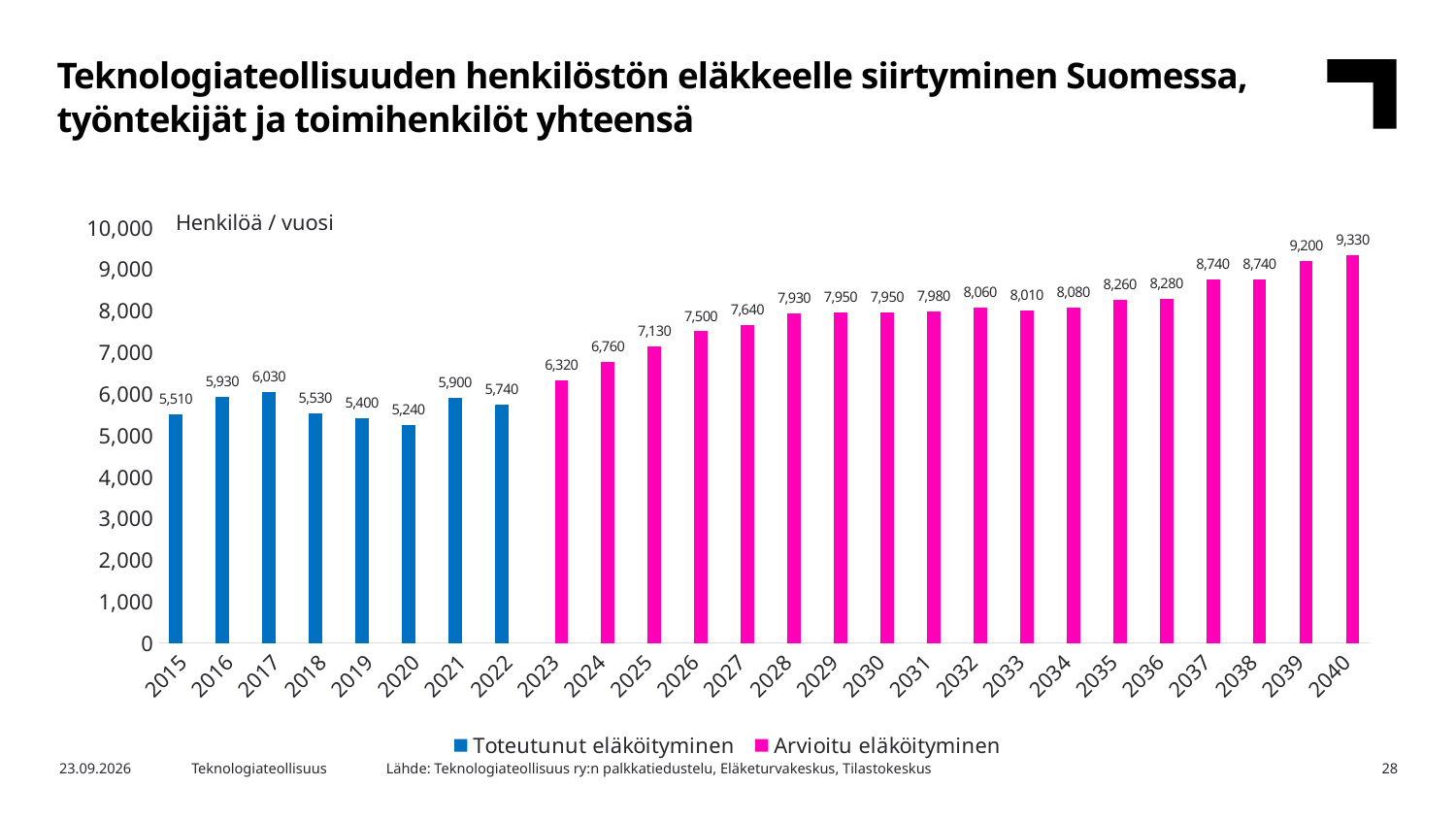
What is the value for 2040? 9,330 What is the value for 2023? 6,320 Which year has the highest value? 2040 What is the difference between the values for 2040 and 2015? 3,820 How many series does the legend list? 2 Which year has the lowest value? 2020 What is the value for 2020? 5,240 Is the value for 2035 greater or less than 8,000? greater How many years are shown on the x axis? 26 Do the values generally rise or fall from 2023 to 2040? rise What kind of chart is shown on the slide? bar chart Which is larger, the value for 2017 or the value for 2022? 2017